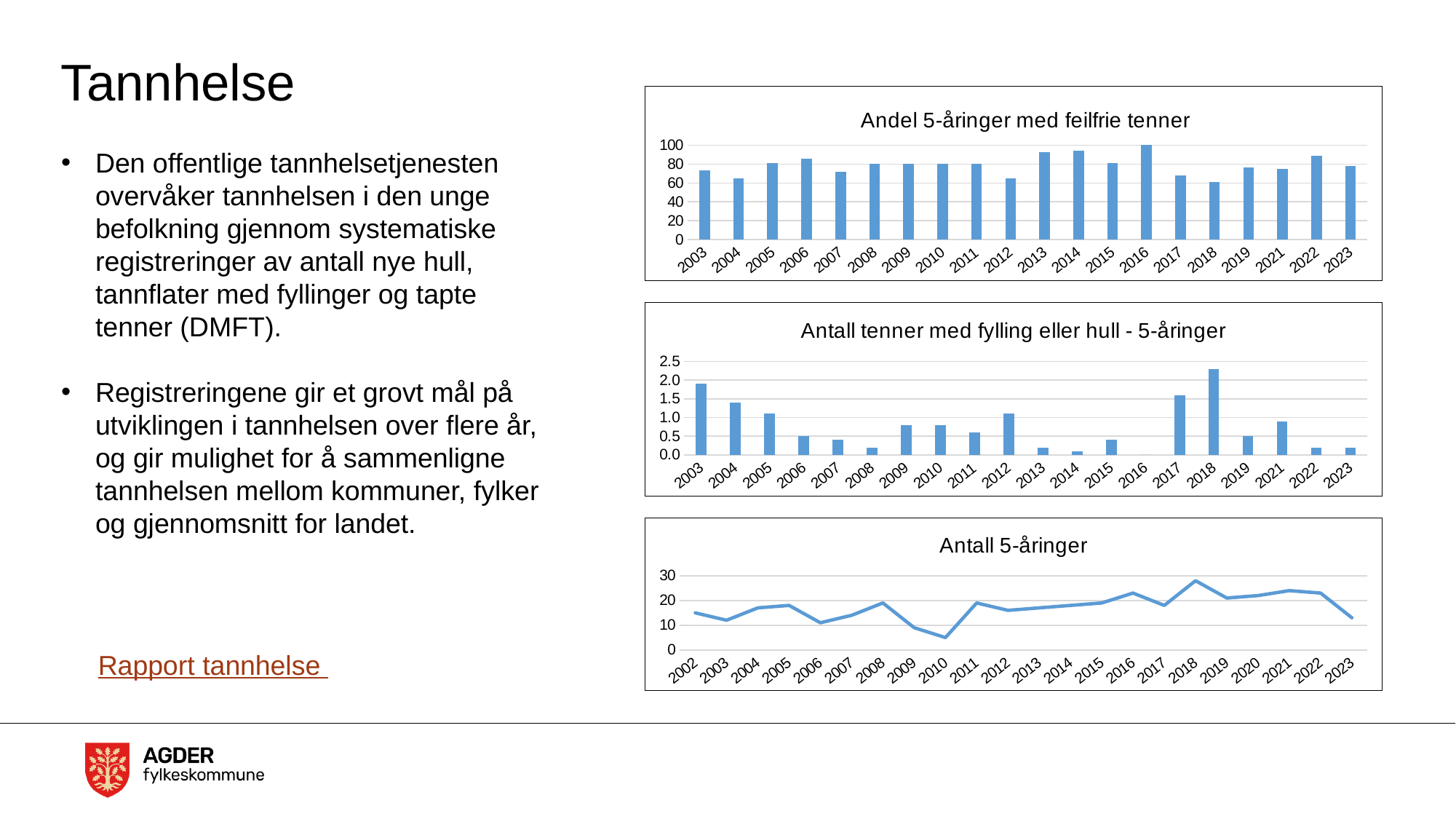
In the bottom chart 'Antall 5-åringer', which year has the highest value? 2018 In the top chart 'Andel 5-åringer med feilfrie tenner', what is the value for 2016? 100 In the top chart 'Andel 5-åringer med feilfrie tenner', which is larger, the value for 2013 or the value for 2018? 2013 In the bottom chart 'Antall 5-åringer', is the value for 2010 greater or less than 10? less What kind of chart is the top chart, 'Andel 5-åringer med feilfrie tenner'? bar chart What kind of chart is the bottom chart, 'Antall 5-åringer'? line chart In the bottom chart 'Antall 5-åringer', how many years are shown on the x axis? 22 In the middle chart 'Antall tenner med fylling eller hull - 5-åringer', which year has the highest value? 2018 In the middle chart 'Antall tenner med fylling eller hull - 5-åringer', is the value for 2003 greater or less than 1.5? greater In the top chart 'Andel 5-åringer med feilfrie tenner', how many years are shown on the x axis? 20 In the bottom chart 'Antall 5-åringer', which year has the lowest value? 2010 In the top chart 'Andel 5-åringer med feilfrie tenner', which year has the highest value? 2016